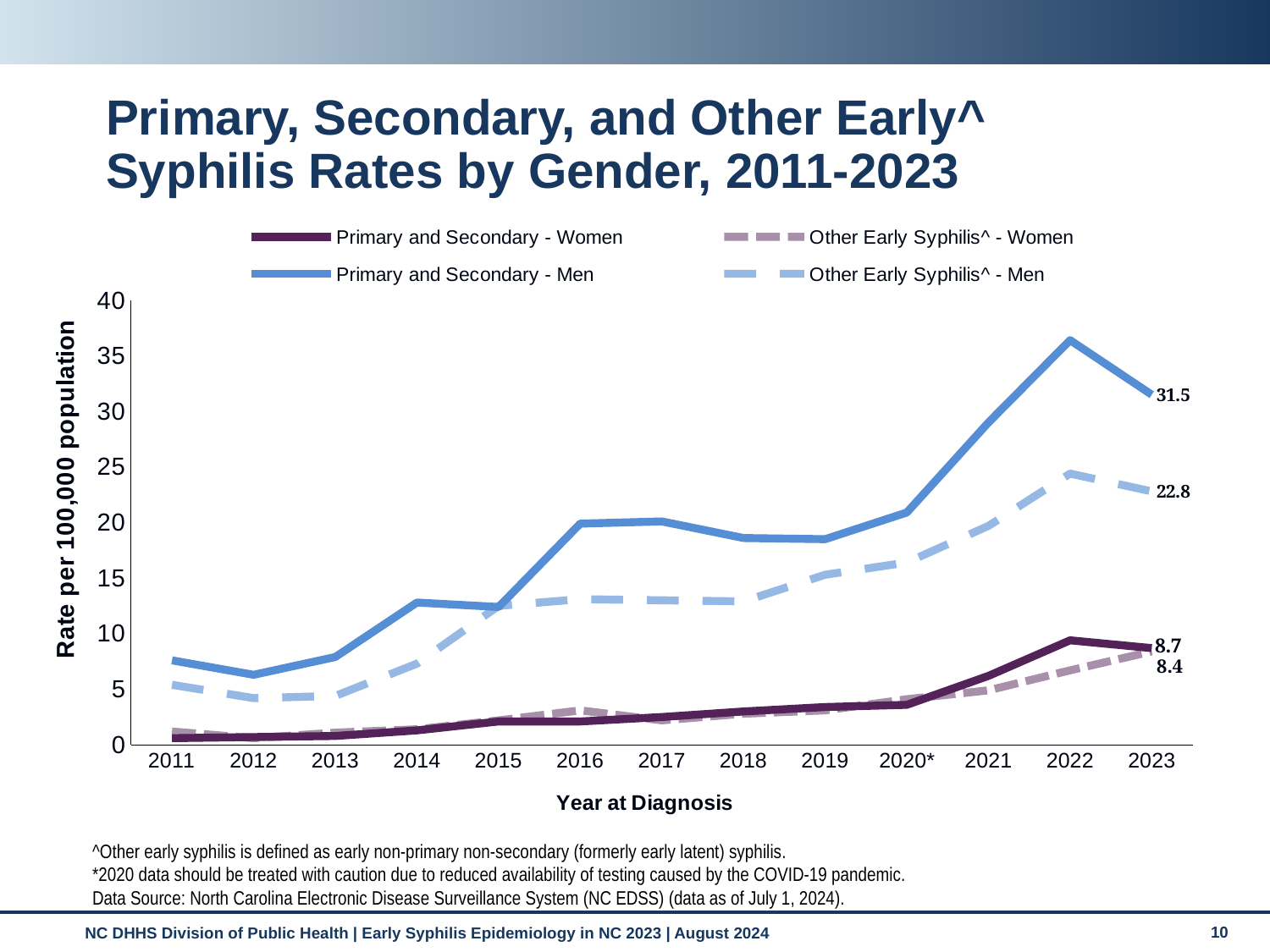
What is the Other Early Syphilis^ - Women rate in 2023? 8.4 What type of chart is shown on the slide? Line chart Is the Primary and Secondary - Men rate in 2022 greater or less than 35? greater In 2023, which is larger: the Primary and Secondary - Men rate or the Other Early Syphilis^ - Men rate? Primary and Secondary - Men How many years are shown on the x axis? 13 What is the difference between the Primary and Secondary - Men rate and the Other Early Syphilis^ - Men rate in 2023? 8.7 What is the Primary and Secondary - Women rate in 2023? 8.7 What is the Other Early Syphilis^ - Men rate in 2023? 22.8 How many series does the legend list? 4 Is the Primary and Secondary - Men rate in 2011 greater or less than 10? less In which year does the Primary and Secondary - Men series reach its highest value? 2022 What is the Primary and Secondary - Men rate in 2023? 31.5